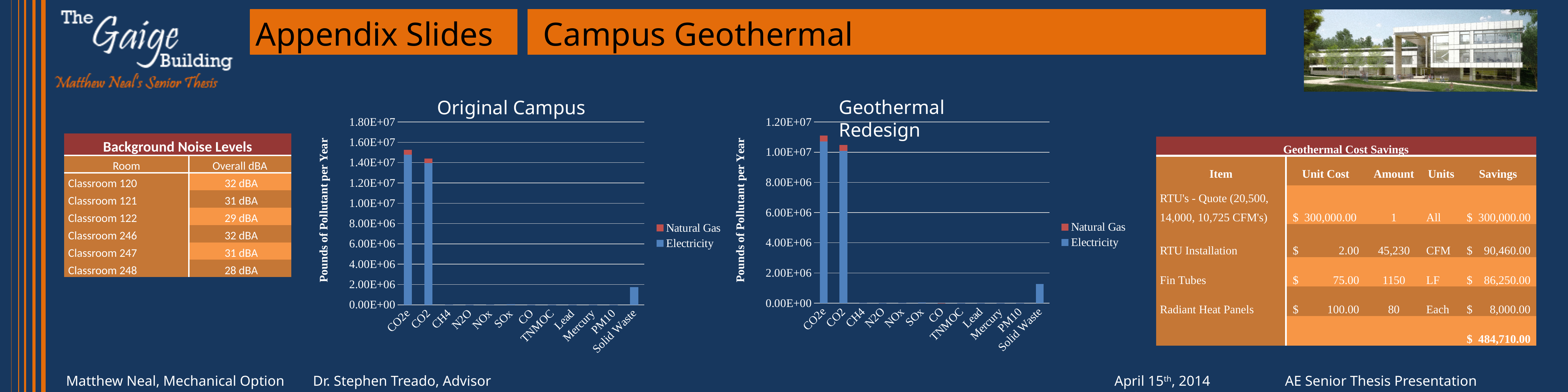
What is the y-axis title of the "Geothermal Redesign" chart? Pounds of Pollutant per Year What kind of chart is the "Original Campus" chart? bar chart In the "Geothermal Redesign" chart, is the value for Solid Waste greater or less than 2.00E+06? less What are the two legend entries in the "Original Campus" chart? Natural Gas and Electricity In the "Original Campus" chart, which has the taller bar, CO2e or CO2? CO2e How many pollutant categories are shown on the x axis of the "Original Campus" chart? 12 In the "Original Campus" chart, is the total value for CO2e greater or less than 1.40E+07? greater In the "Original Campus" chart, is the value for Solid Waste greater or less than 2.00E+06? less How many series does the legend of the "Geothermal Redesign" chart list? 2 In the "Geothermal Redesign" chart, which category has the tallest bar? CO2e In the "Original Campus" chart, which category has the tallest bar? CO2e